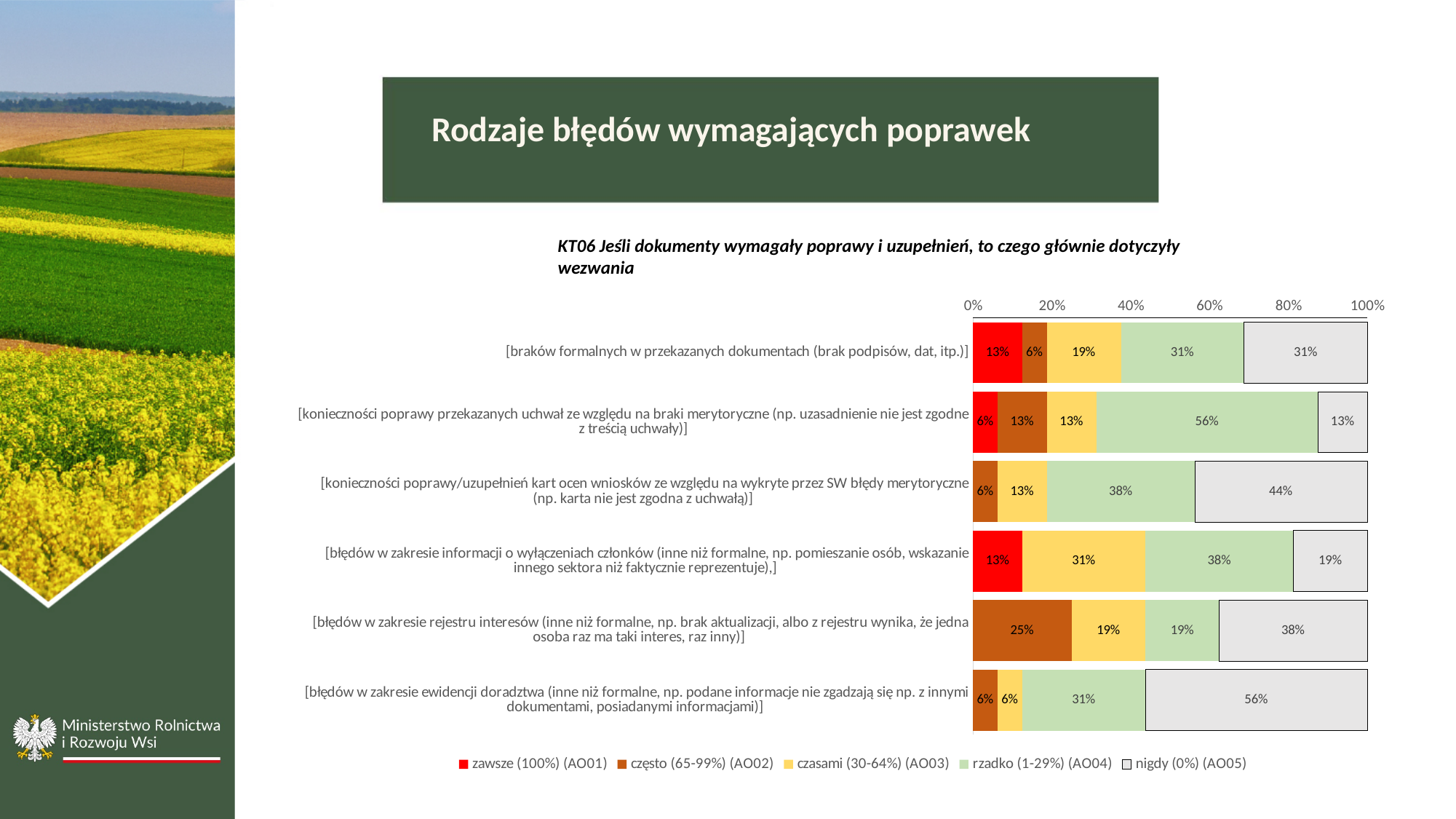
How many series does the legend list? 5 What is the value of 'rzadko (1-29%) (AO04)' for 'konieczności poprawy przekazanych uchwał ze względu na braki merytoryczne'? 56% Which category has the highest value for 'nigdy (0%) (AO05)'? błędów w zakresie ewidencji doradztwa What kind of chart is shown on the slide? Stacked bar chart Which is larger: the 'rzadko (1-29%) (AO04)' value for 'braków formalnych w przekazanych dokumentach' or for 'błędów w zakresie rejestru interesów'? braków formalnych w przekazanych dokumentach Which category has the highest value for 'często (65-99%) (AO02)'? błędów w zakresie rejestru interesów Which colour represents 'zawsze (100%) (AO01)' in the legend? Red What is the value of 'często (65-99%) (AO02)' for 'błędów w zakresie rejestru interesów'? 25% What is the value of 'nigdy (0%) (AO05)' for 'błędów w zakresie ewidencji doradztwa'? 56% What is the value of 'czasami (30-64%) (AO03)' for 'błędów w zakresie informacji o wyłączeniach członków'? 31% What is the difference between the 'nigdy (0%) (AO05)' values for 'konieczności poprawy/uzupełnień kart ocen wniosków' and 'błędów w zakresie informacji o wyłączeniach członków'? 25% How many categories (rows) are plotted in the chart? 6